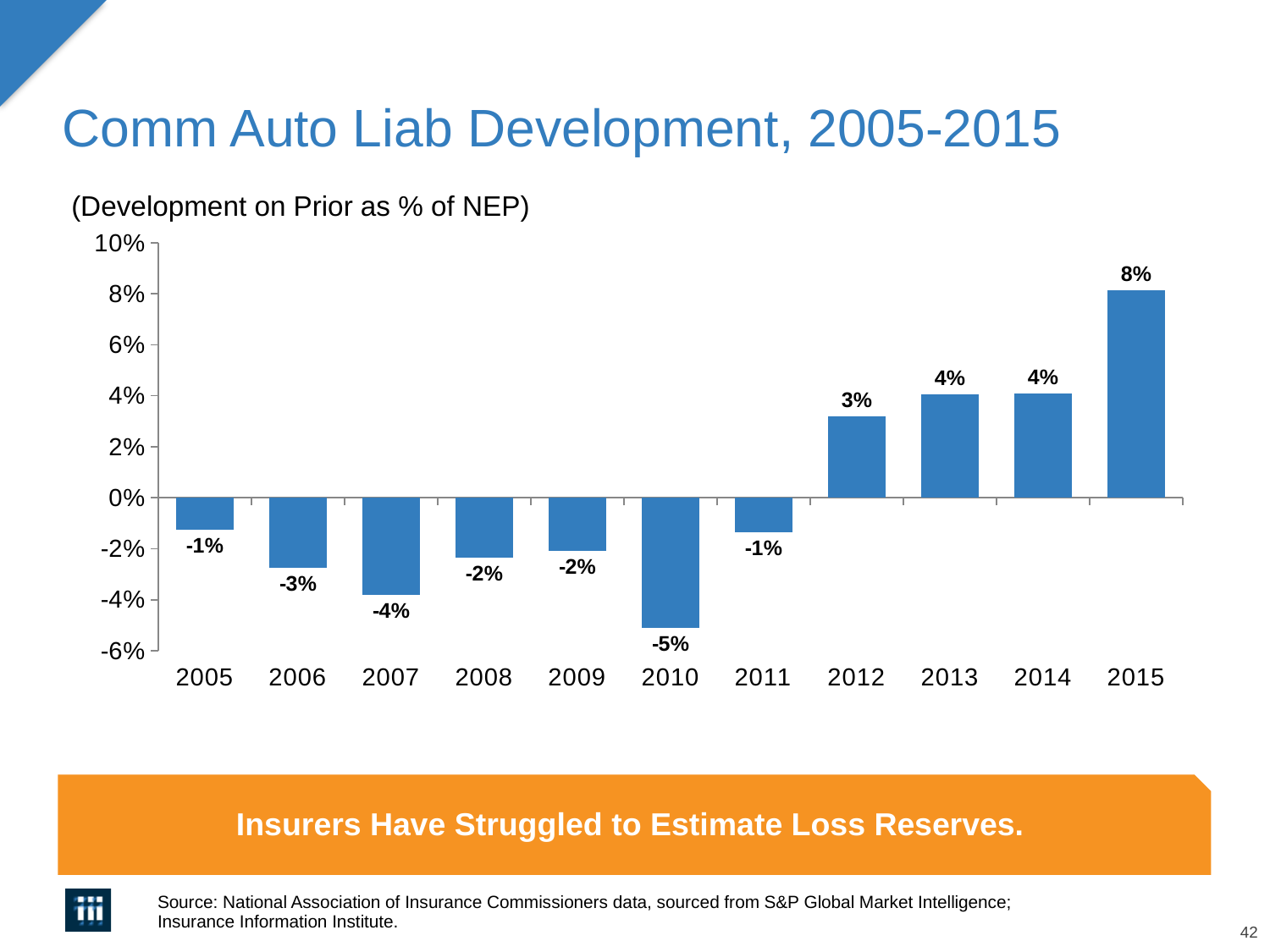
What is the difference between the 2015 value and the 2014 value? 4% What is the title of the chart? Comm Auto Liab Development, 2005-2015 Which year has the lowest development value? 2010 What kind of chart is shown on the slide? Bar chart Do the values generally rise or fall from 2011 to 2015? Rise Is the value for 2015 greater or less than 6%? greater Which year has the highest development value? 2015 Which year has the larger value, 2007 or 2013? 2013 How many years are shown on the x axis? 11 What is the development value for 2012? 3% What is the development value for 2015? 8% What is the development value for 2010? -5%